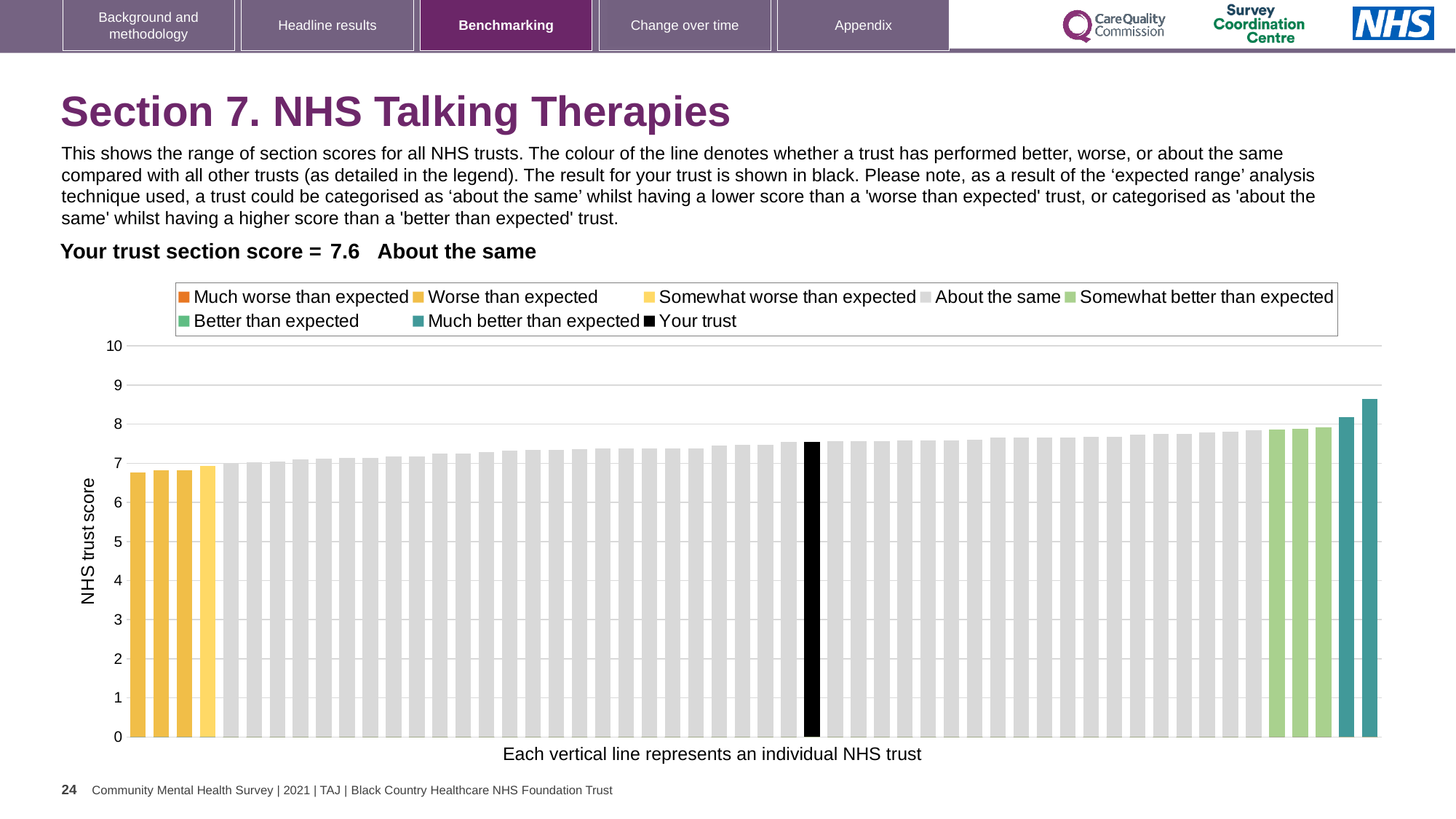
What is the section score for your trust? 7.6 Is the value of the black bar (your trust) greater or less than 8? less Is the value of the shortest bar greater or less than 7? less Which legend category does the tallest bar belong to? Much better than expected How many bars are coloured as 'Much better than expected' (teal)? 2 What is the label on the y axis of the chart? NHS trust score Is the value of the black bar (your trust) greater or less than 7? greater Which category is your trust placed in for this section? About the same How many entries does the chart legend list? 8 What kind of chart is shown on the slide? bar chart Do the bar values rise or fall from left to right along the x axis? rise